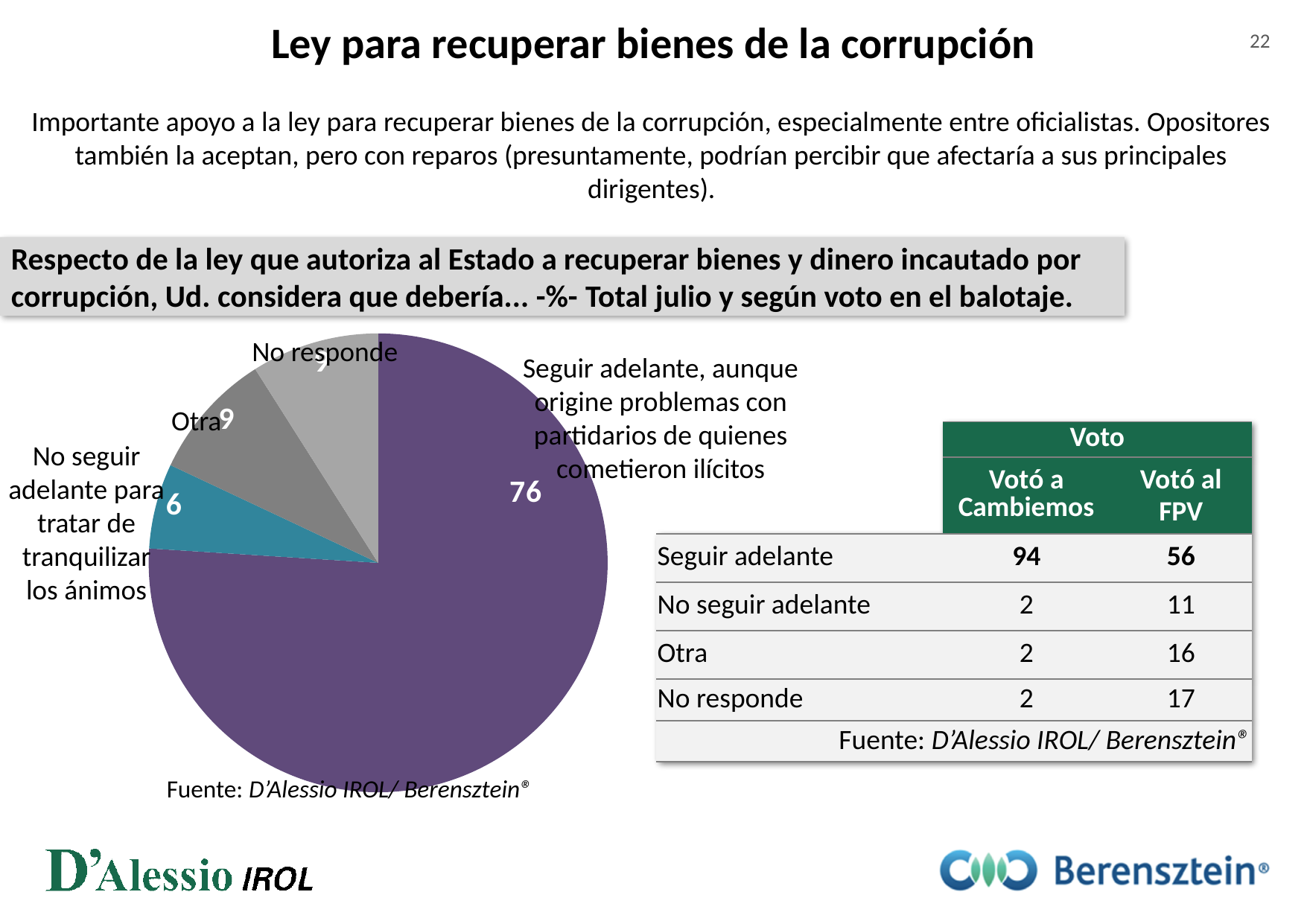
In the pie chart, what percentage of respondents chose 'Seguir adelante, aunque origine problemas con partidarios de quienes cometieron ilícitos'? 76 How many slices does the pie chart have? 4 In the pie chart, which is larger: the 'Otra' slice or the 'No seguir adelante' slice? Otra What colour is the largest slice of the pie chart? Purple In the pie chart, what is the difference between the 'Seguir adelante' value and the 'No seguir adelante' value? 70 In the pie chart, what is the difference between the 'Seguir adelante' value and the 'Otra' value? 67 In the pie chart, what value is shown for 'No seguir adelante para tratar de tranquilizar los ánimos'? 6 In the pie chart, what value is shown for the 'Otra' slice? 9 Which slice of the pie chart is the smallest? No seguir adelante para tratar de tranquilizar los ánimos Which slice of the pie chart is the largest? Seguir adelante, aunque origine problemas con partidarios de quienes cometieron ilícitos What share of the pie does the 'Seguir adelante' slice represent? 76% What type of chart is shown on the slide? Pie chart